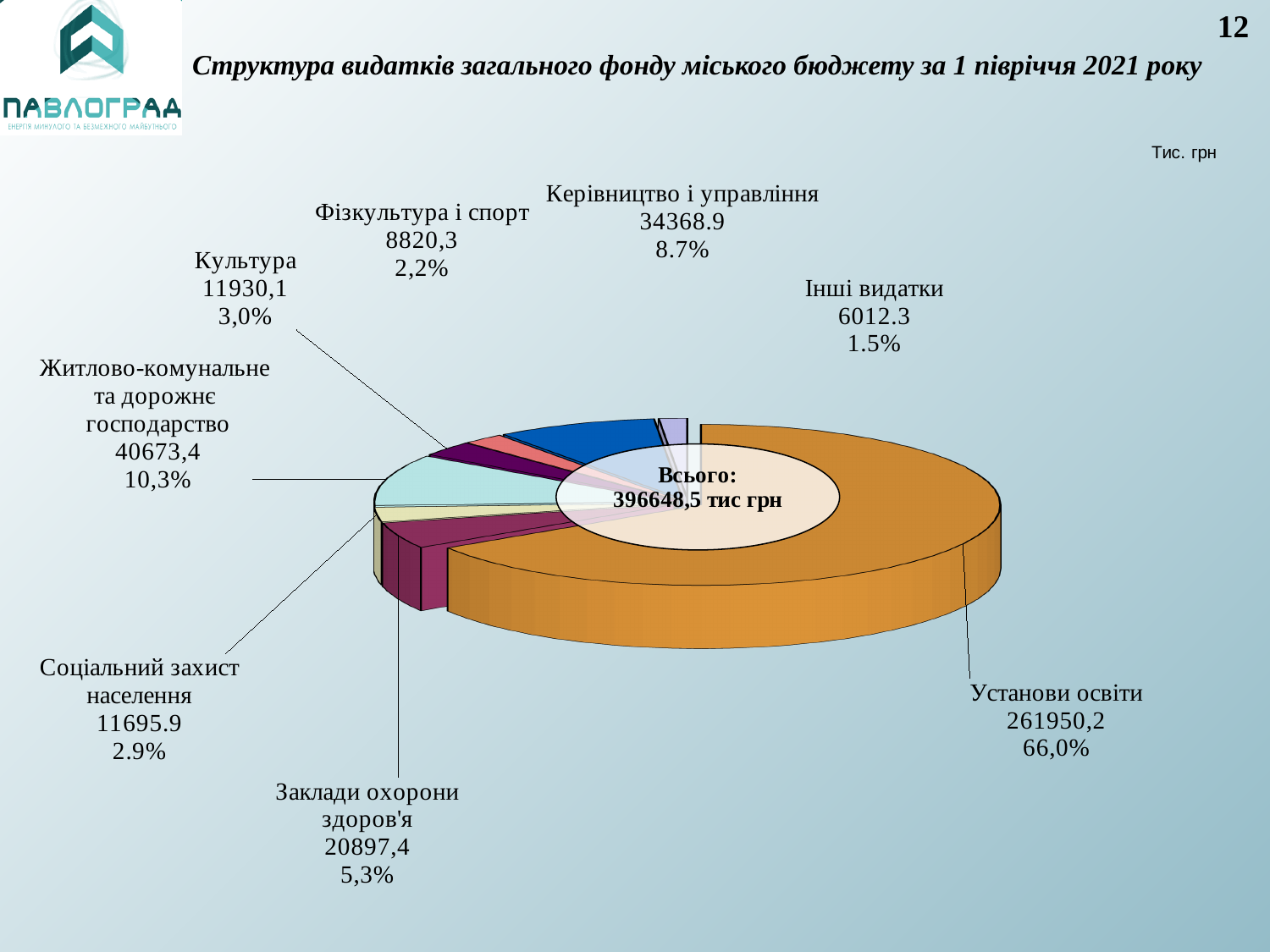
What is the difference between the values for Житлово-комунальне та дорожнє господарство and Заклади охорони здоров'я? 19776,0 Which category has the largest slice of the pie? Установи освіти What unit is indicated for the values on the slide? Тис. грн What is the value shown for Керівництво і управління? 34368.9 Which category has the smallest slice of the pie? Інші видатки What share of the pie does Соціальний захист населення have? 2.9% What is the value shown for Установи освіти? 261950,2 What total is printed in the centre of the chart? 396648,5 тис грн What kind of chart is shown on the slide? Pie chart What share of the pie does Житлово-комунальне та дорожнє господарство have? 10,3% How many categories are shown in the pie chart? 8 Which is larger, Культура or Фізкультура і спорт? Культура